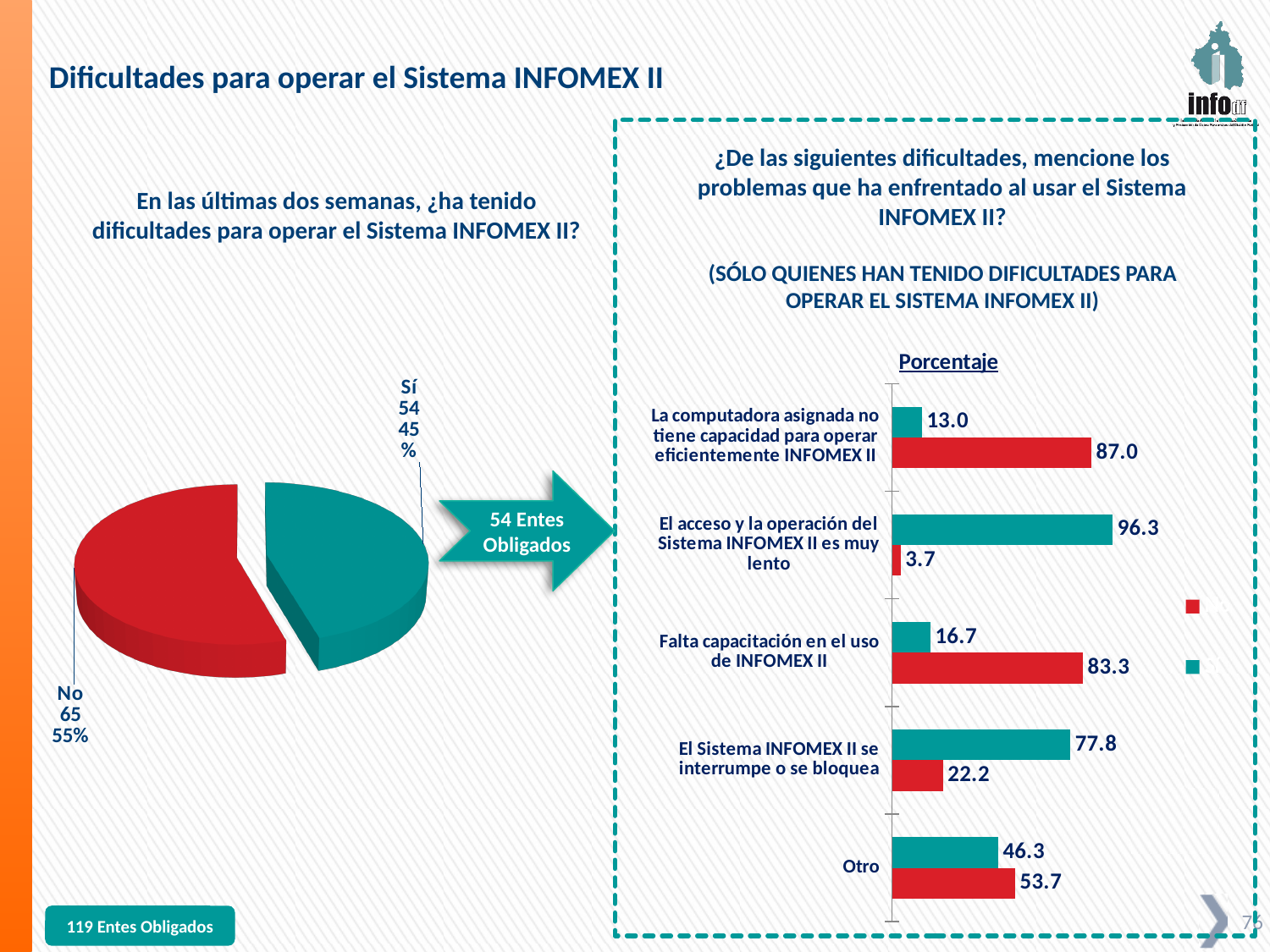
How many categories are shown in the 'Porcentaje' bar chart on the right? 5 What kind of chart is the chart on the left of the slide? pie chart In the 'Porcentaje' bar chart on the right, what is the difference between the red bar and the teal bar for 'Otro'? 7.4 In the 'Porcentaje' bar chart on the right, what is the value of the teal bar for 'El acceso y la operación del Sistema INFOMEX II es muy lento'? 96.3 What kind of chart is the 'Porcentaje' chart on the right of the slide? bar chart How many slices does the pie chart on the left have? 2 In the pie chart on the left, what share of the pie does the 'No' slice represent? 55% In the 'Porcentaje' bar chart on the right, which category has the highest teal bar? El acceso y la operación del Sistema INFOMEX II es muy lento In the 'Porcentaje' bar chart on the right, what is the value of the red bar for 'La computadora asignada no tiene capacidad para operar eficientemente INFOMEX II'? 87.0 In the pie chart on the left, what is the value shown for 'No'? 65 In the pie chart on the left, what share of the pie does the 'Sí' slice represent? 45% In the pie chart on the left, which slice is larger, 'Sí' or 'No'? No